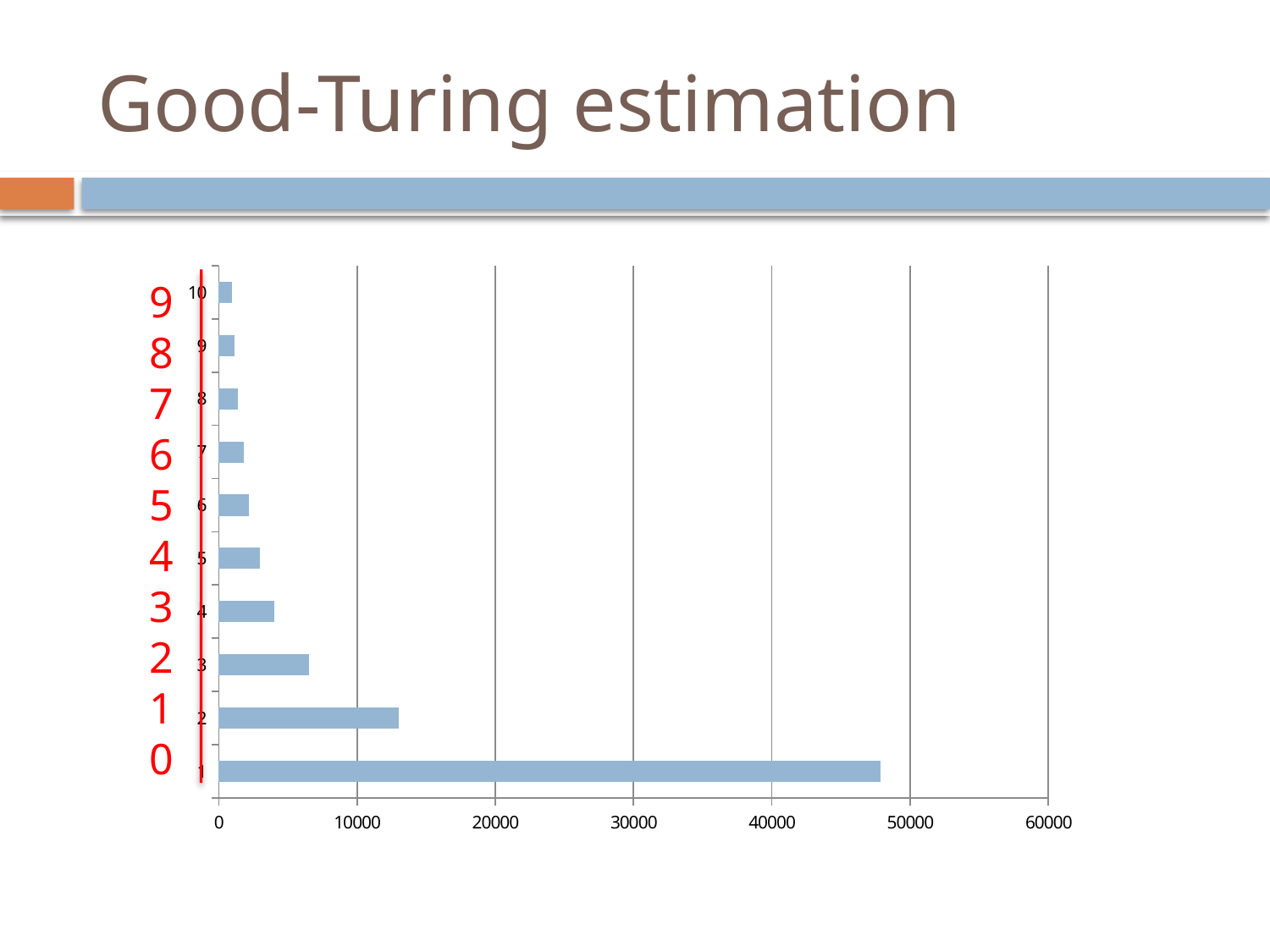
What is the title of the slide containing the chart? Good-Turing estimation What is the highest tick value shown on the horizontal axis? 60000 What kind of chart is shown on the slide? bar chart How many bars are plotted in the chart? 10 Do the bar values increase or decrease as you move from the bottom bar to the top bar? decrease Which is larger: the value of the second bar from the bottom (category 2) or the third bar from the bottom (category 3)? category 2 Is the value of the bottom bar (category 1) greater or less than 40000? greater Is the value of the third bar from the bottom (category 3) greater or less than 10000? less Is the value of the bottom bar (category 1) greater or less than 50000? less Which bar has the highest value in the chart? the bottom bar (category 1)